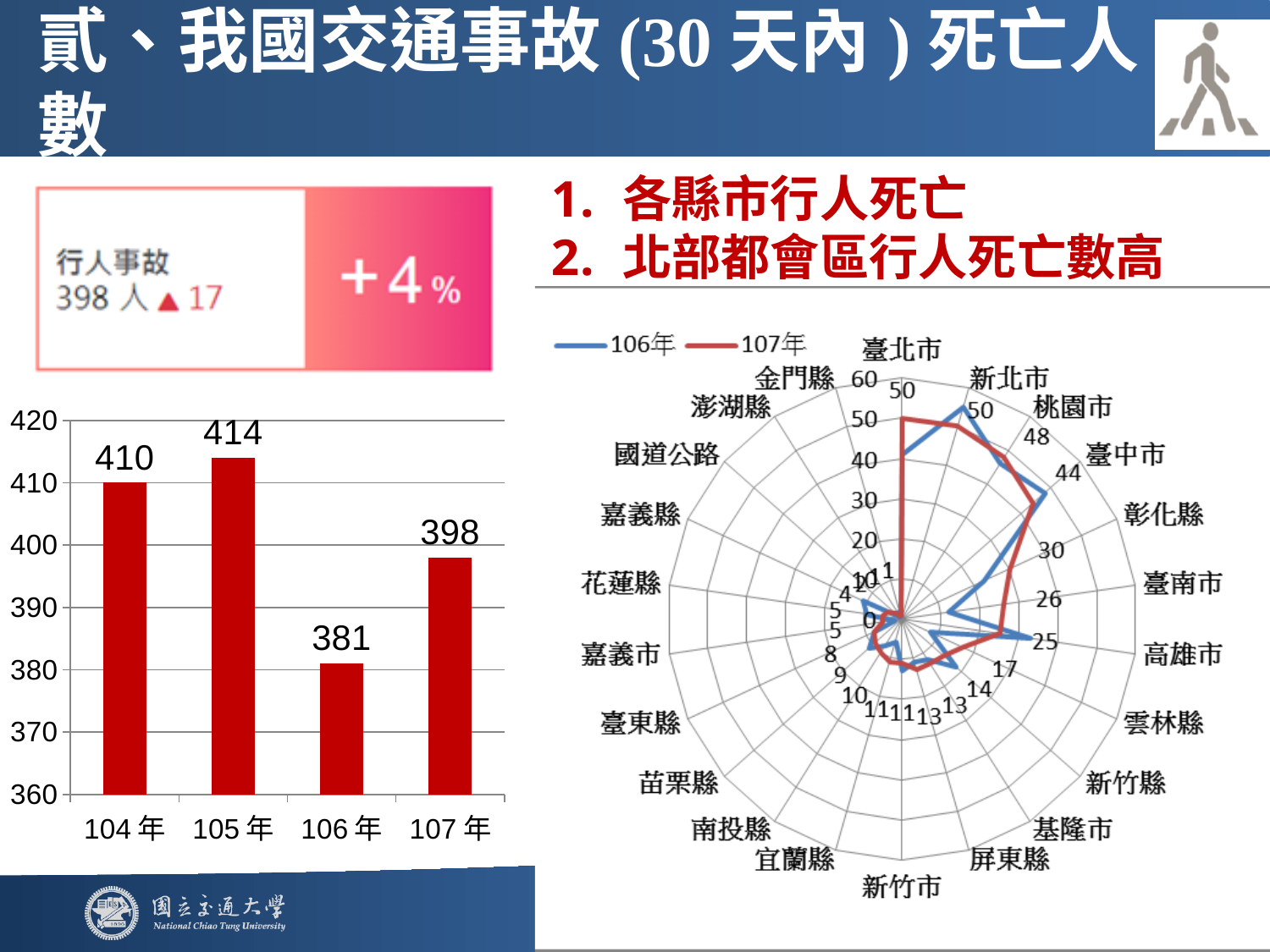
In the bar chart on the left, what is the difference between the values for 107年 and 106年? 17 What kind of chart is the chart on the right? radar chart What kind of chart is the chart on the left? bar chart In the bar chart on the left, which year has the highest value? 105年 In the bar chart on the left, does the value rise or fall from 105年 to 106年? fall In the bar chart on the left, what is the value for 105年? 414 In the radar chart on the right, is the 107年 value for 臺北市 greater or less than 40? greater How many series does the legend of the radar chart on the right list? 2 In the bar chart on the left, what is the value for 106年? 381 In the bar chart on the left, how many years are shown? 4 In the bar chart on the left, which is larger, the value for 104年 or the value for 107年? 104年 In the bar chart on the left, which year has the lowest value? 106年